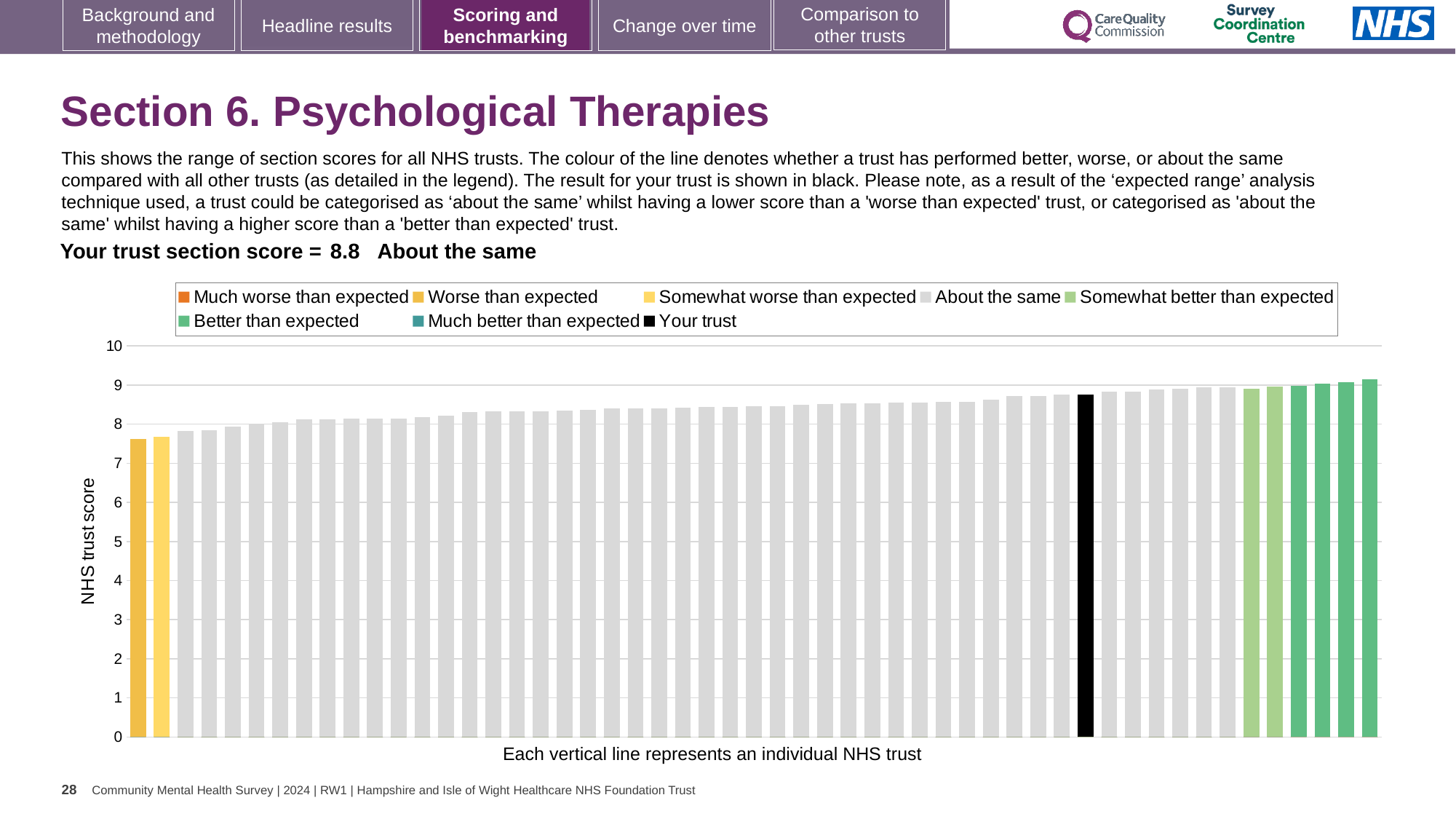
How many entries does the chart legend list? 8 Do the bar values rise or fall from left to right across the chart? rise Is the value of the rightmost bar greater or less than 9? greater Is the value of the leftmost bar greater or less than 8? less Which category is your trust's section score placed in? About the same Which is larger: the score for your trust or the score of the leftmost bar? your trust What is the maximum value shown on the vertical axis? 10 What is the label on the vertical axis of the chart? NHS trust score Is the value for your trust greater or less than 8? greater What colour is the bar representing your trust? black What is the section score for your trust shown on the slide? 8.8 What type of chart is shown on the slide? bar chart